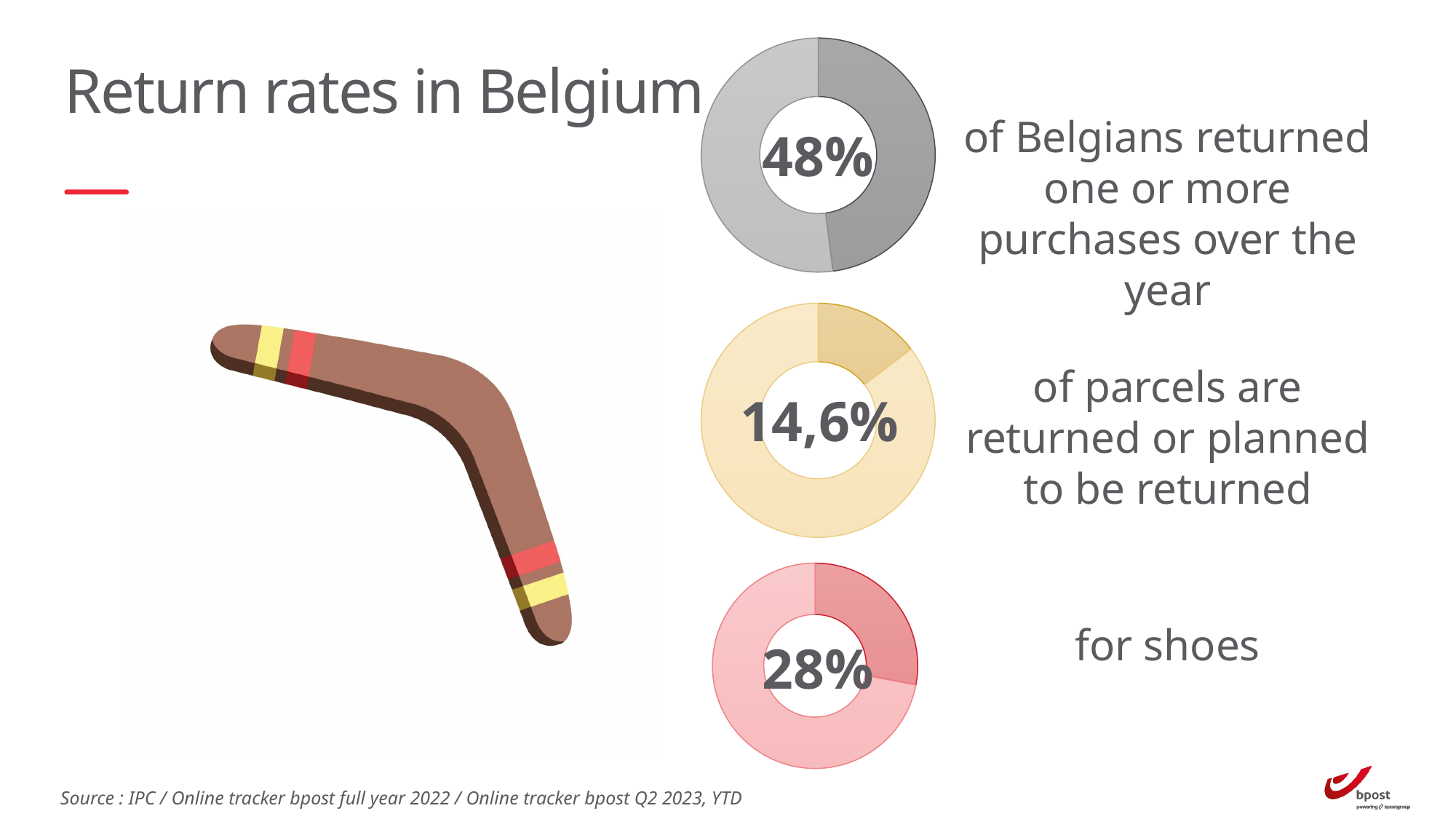
What is the return rate for shoes shown in the bottom donut chart? 28% What is the title of the slide containing the donut charts? Return rates in Belgium How many donut charts are shown on the slide? 3 Which of the three donut charts shows the lowest percentage? The middle chart (14,6%, parcels returned or planned to be returned) What percentage of Belgians returned one or more purchases over the year, according to the top donut chart? 48% What is the difference in percentage points between the share of Belgians who returned one or more purchases (48%) and the return rate for shoes (28%)? 20 percentage points What kind of chart is used to show the return rates on this slide? Donut (pie) chart What colour is the donut chart showing the return rate for shoes? Red/pink Which is larger: the return rate for shoes or the share of parcels returned or planned to be returned? The return rate for shoes (28%) Which of the three donut charts shows the highest percentage? The top chart (48%, Belgians who returned one or more purchases) What is the difference in percentage points between the return rate for shoes (28%) and the share of parcels returned or planned to be returned (14,6%)? 13,4 percentage points What percentage of parcels are returned or planned to be returned, according to the middle donut chart? 14,6%